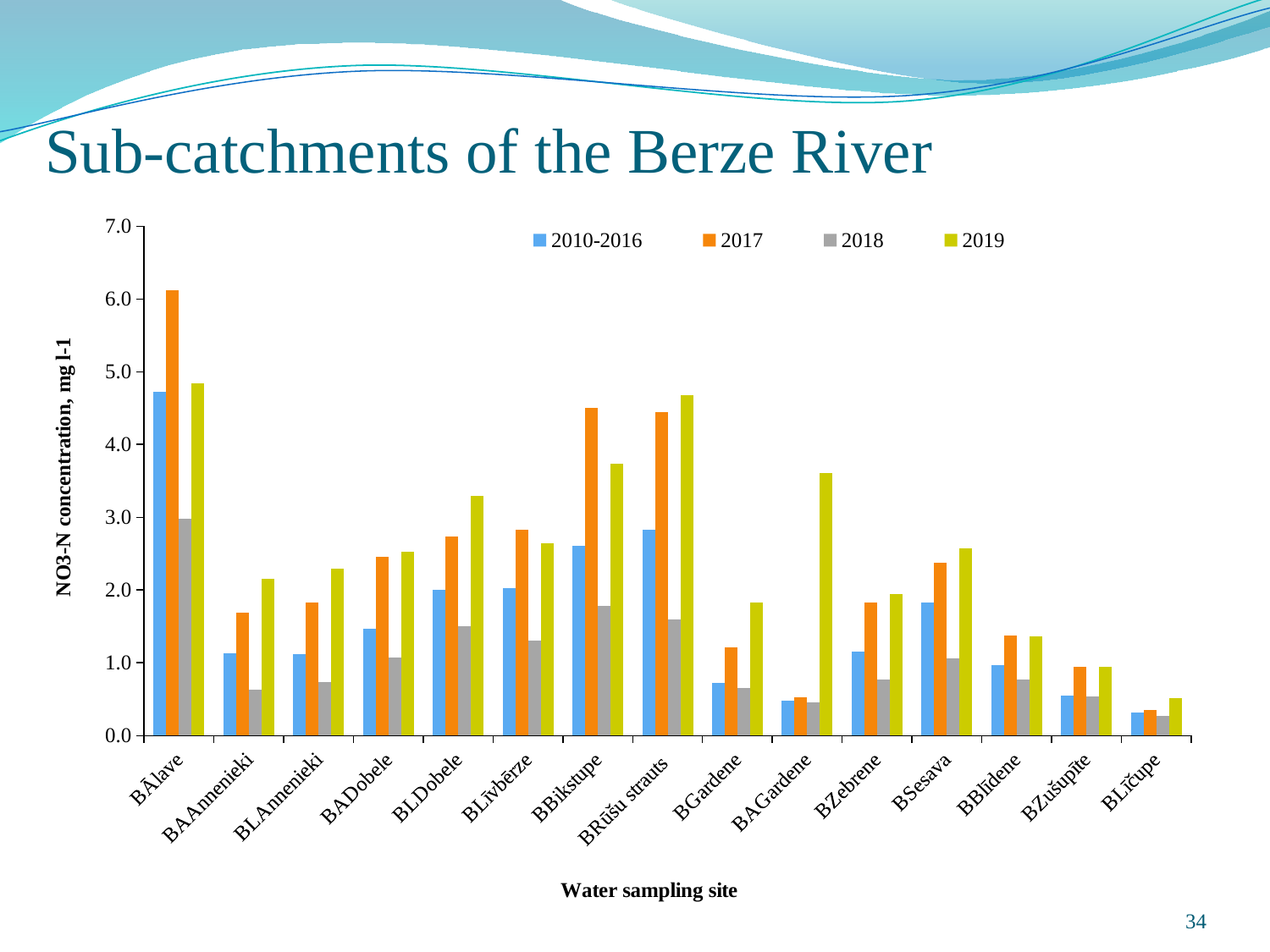
Is the 2017 value for BĀlave greater or less than 5.0? greater How many water sampling sites are shown on the x axis? 15 How many series does the legend list? 4 Is the 2010-2016 value for BGardene greater or less than 1.0? less Which water sampling site has the lowest 2019 value? BLīčupe What is the label of the y axis? NO3-N concentration, mg l-1 Which is larger at BAGardene, the 2017 value or the 2019 value? 2019 Is the 2019 value for BAGardene greater or less than 3.0? greater Which water sampling site has the highest 2018 value? BĀlave Which water sampling site has the highest 2017 value? BĀlave What kind of chart is shown on the slide? bar chart